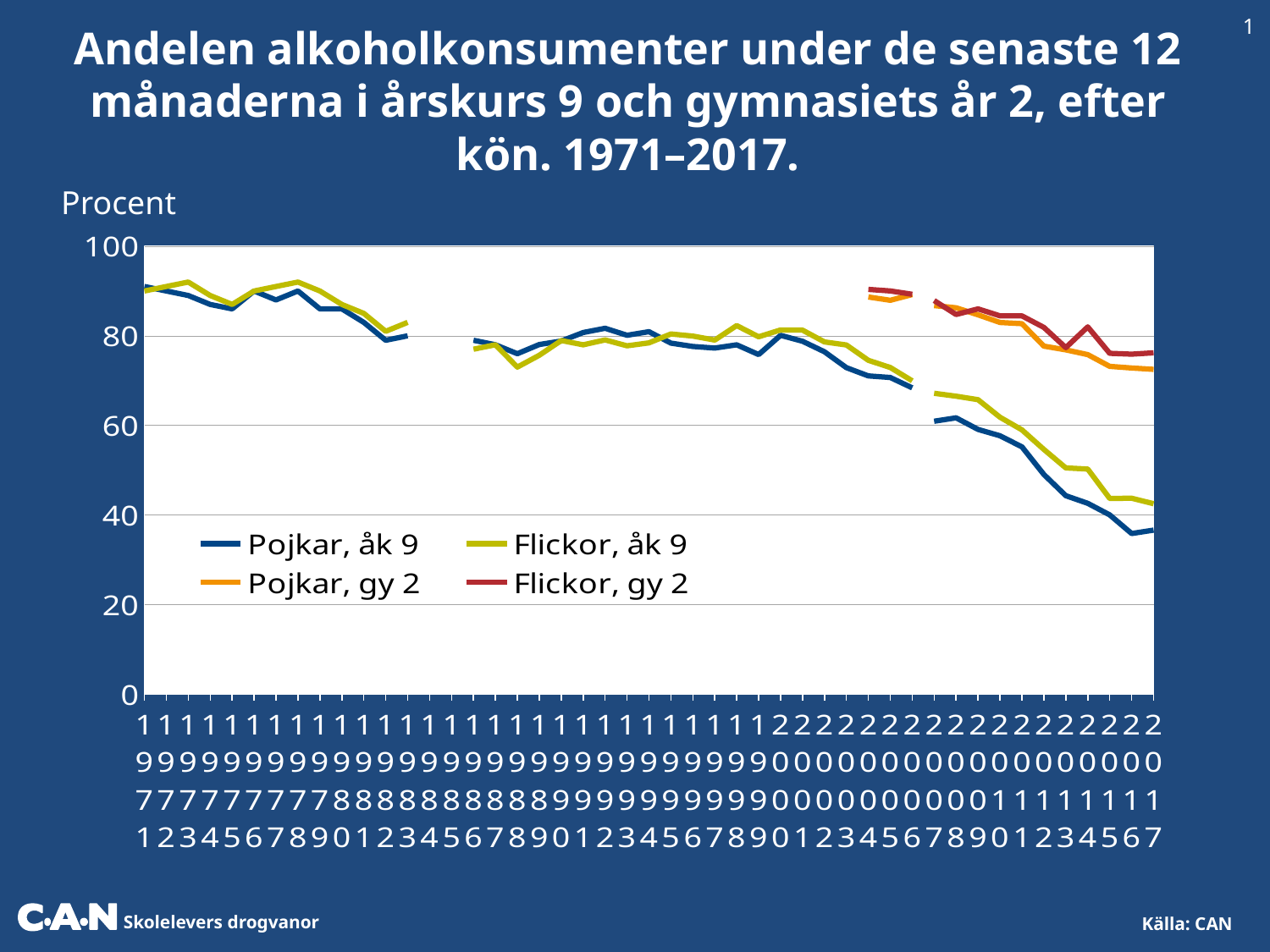
Is the value for Flickor, åk 9 in 2017 greater or less than 60? less Is the value for Pojkar, åk 9 in 1971 greater or less than 80? greater Which series are listed in the legend? Pojkar, åk 9; Flickor, åk 9; Pojkar, gy 2; Flickor, gy 2 Does the value for Pojkar, åk 9 rise or fall from 2000 to 2017? Fall What kind of chart is shown on the slide? Line chart Which series has the highest value in 2017? Flickor, gy 2 Is the value for Pojkar, åk 9 in 2017 greater or less than 40? less What is the label of the vertical axis? Procent In 2017, which is higher: Flickor, åk 9 or Pojkar, åk 9? Flickor, åk 9 How many series does the legend list? 4 Which series has the lowest value in 2017? Pojkar, åk 9